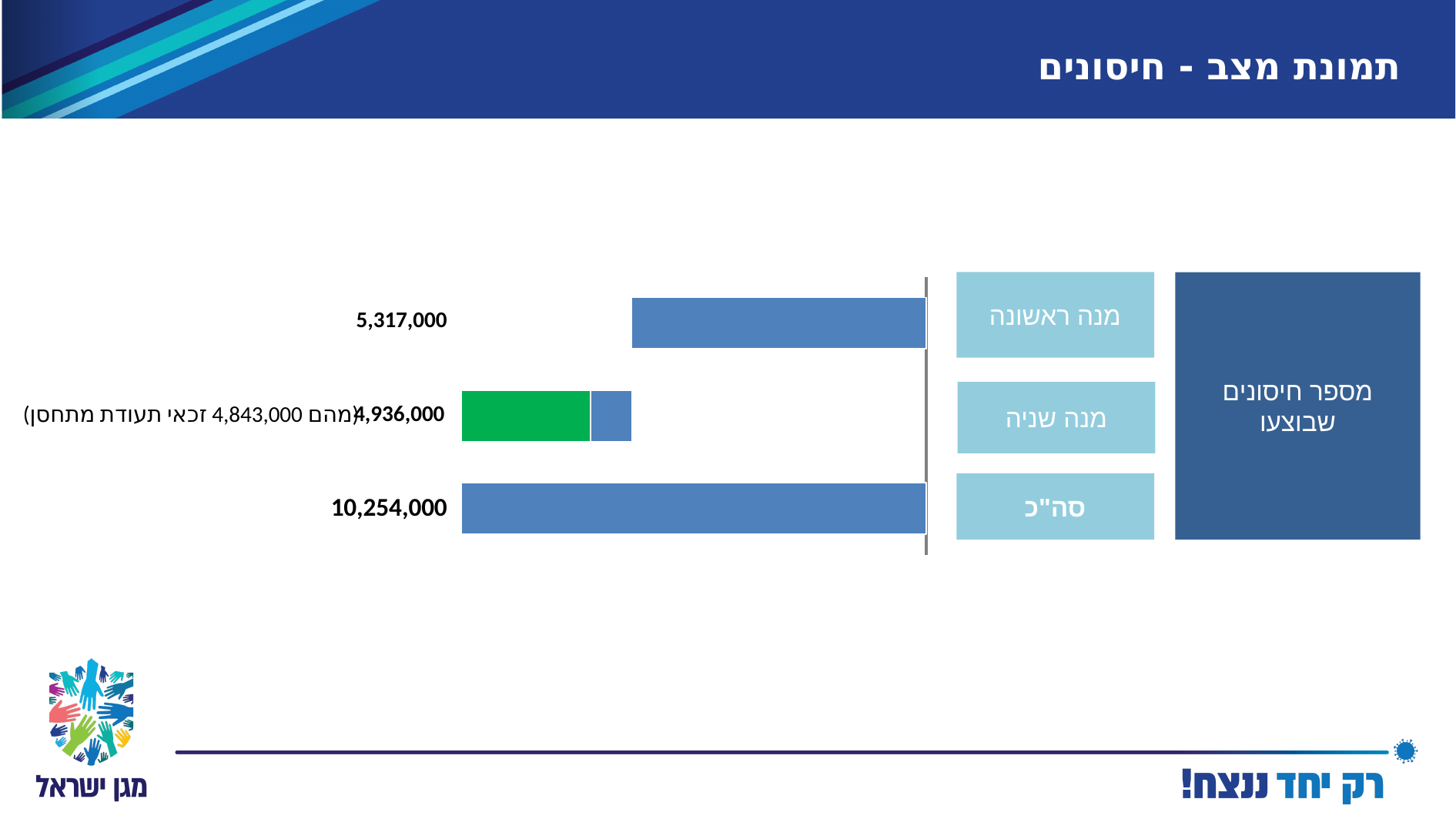
What is the value shown for מנה ראשונה (first dose)? 5,317,000 What is the value shown for מנה שניה (second dose)? 4,936,000 What is the value shown for סה"כ (total)? 10,254,000 What is the difference between the first-dose value and the second-dose value? 381,000 Which category has the lowest value? מנה שניה What is the title of the slide? תמונת מצב - חיסונים What is the difference between the total (סה"כ) and the first-dose value? 4,937,000 Which category has the highest value? סה"כ How many categories (bars) does the chart show? 3 Which is larger, the value for מנה ראשונה or the value for מנה שניה? מנה ראשונה According to the note next to the second-dose bar, how many people are eligible for a vaccination certificate (זכאי תעודת מתחסן)? 4,843,000 What kind of chart is shown on the slide? Bar chart